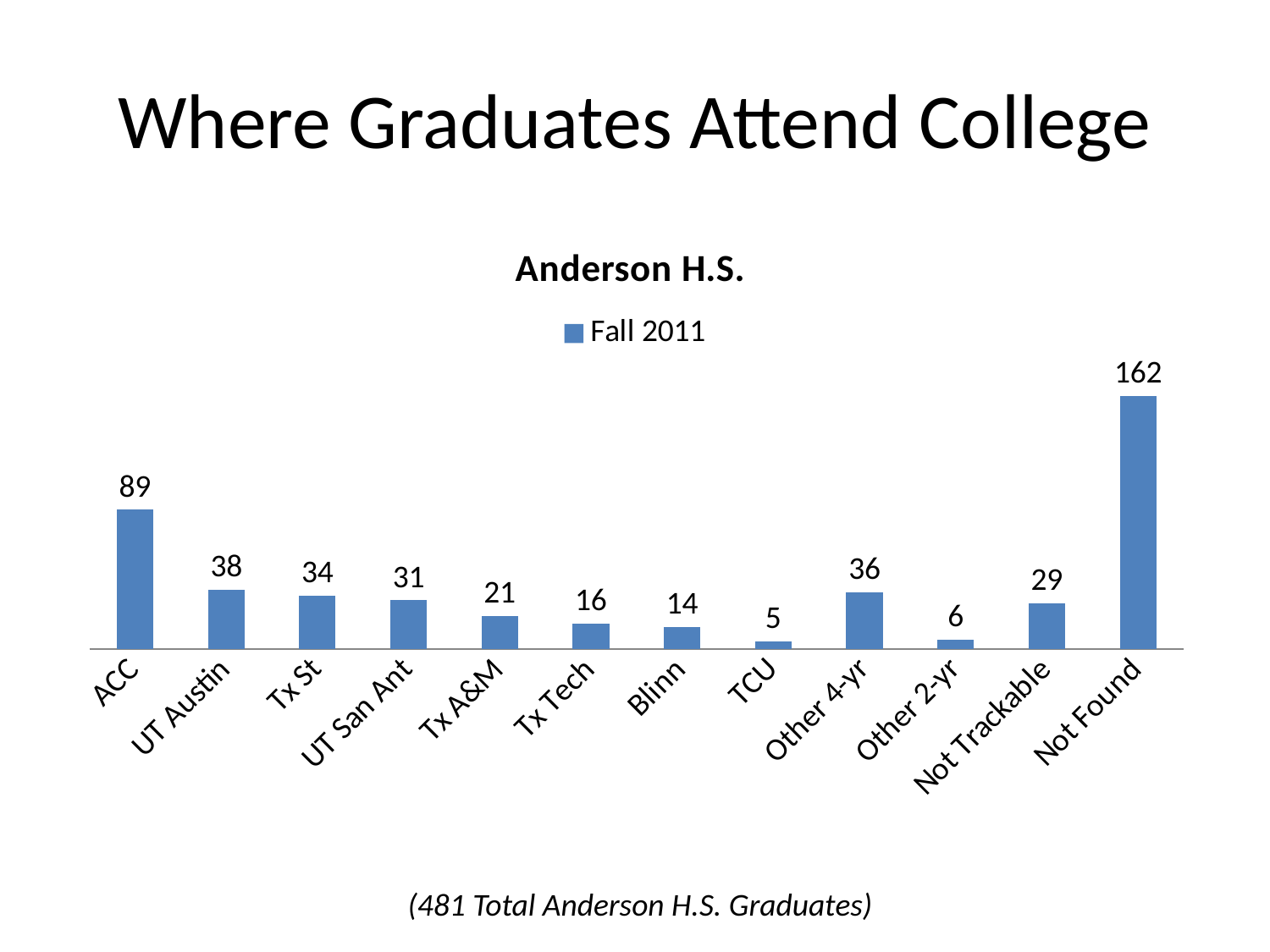
What kind of chart is shown? bar chart How many series does the legend list? 1 What is the value for Not Found? 162 What is the value for Other 4-yr? 36 What is the difference between the values for Not Found and ACC? 73 Which category has the highest value? Not Found How many categories are shown on the x axis? 12 Which is larger, the value for Tx A&M or the value for Not Trackable? Not Trackable What is the difference between the values for UT Austin and Tx St? 4 What is the title of the chart? Anderson H.S. Which category has the lowest value? TCU What is the value for ACC? 89